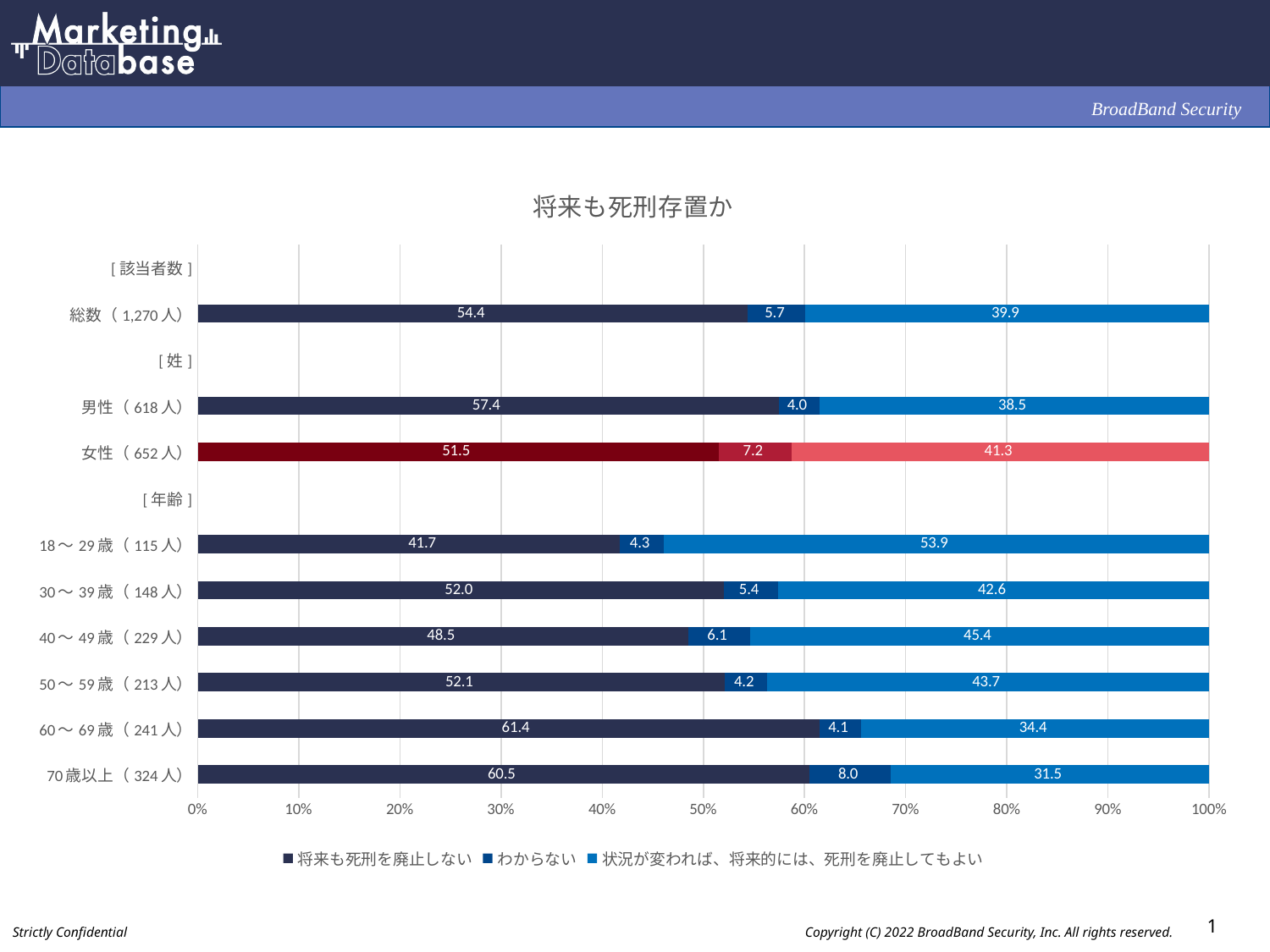
What is the value for 18～29歳 (115人) in the 状況が変われば、将来的には、死刑を廃止してもよい series? 53.9 Which category's bar is highlighted in red instead of blue? 女性 (652人) Which category has the lowest value in the 将来も死刑を廃止しない series? 18～29歳 (115人) Which category has the highest value in the 将来も死刑を廃止しない series? 60～69歳 (241人) How many categories with plotted bars are shown on the chart? 9 Which is larger in the 状況が変われば、将来的には、死刑を廃止してもよい series: 40～49歳 (229人) or 60～69歳 (241人)? 40～49歳 (229人) What is the difference between 男性 (618人) and 女性 (652人) in the 将来も死刑を廃止しない series? 5.9 What is the value for 女性 (652人) in the わからない series? 7.2 Which category has the highest value in the わからない series? 70歳以上 (324人) What kind of chart is shown on the slide? Stacked horizontal bar chart What is the value for 総数 (1,270人) in the 将来も死刑を廃止しない series? 54.4 How many series does the legend list? 3